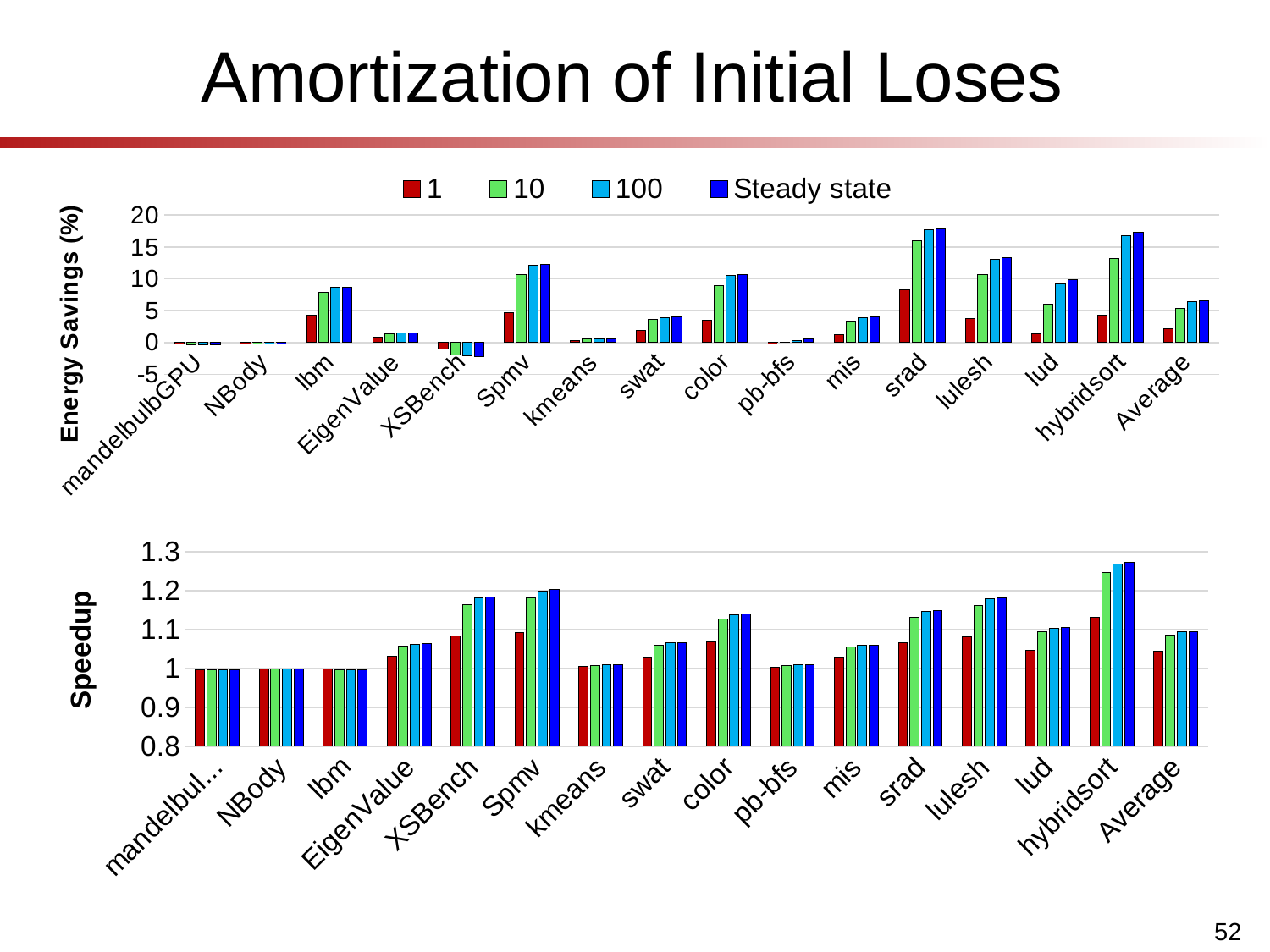
In the bottom Speedup chart, which has the larger Steady state speedup, XSBench or kmeans? XSBench In the bottom Speedup chart, which category has the highest speedup? hybridsort In the top Energy Savings chart, which category has the lowest (negative) energy savings? XSBench In the top Energy Savings chart, is the Steady state value for srad greater or less than 15? greater In the bottom Speedup chart, is the Steady state value for hybridsort greater or less than 1.2? greater What is the label of the y axis on the top chart? Energy Savings (%) What kind of chart is the top chart (Energy Savings)? bar chart How many series does the legend list for the charts? 4 In the top Energy Savings chart, which has the larger Steady state energy savings, Spmv or lbm? Spmv In the top Energy Savings chart, is the Steady state value for lbm greater or less than 10? less How many benchmark categories are shown on the x axis of the bottom Speedup chart? 16